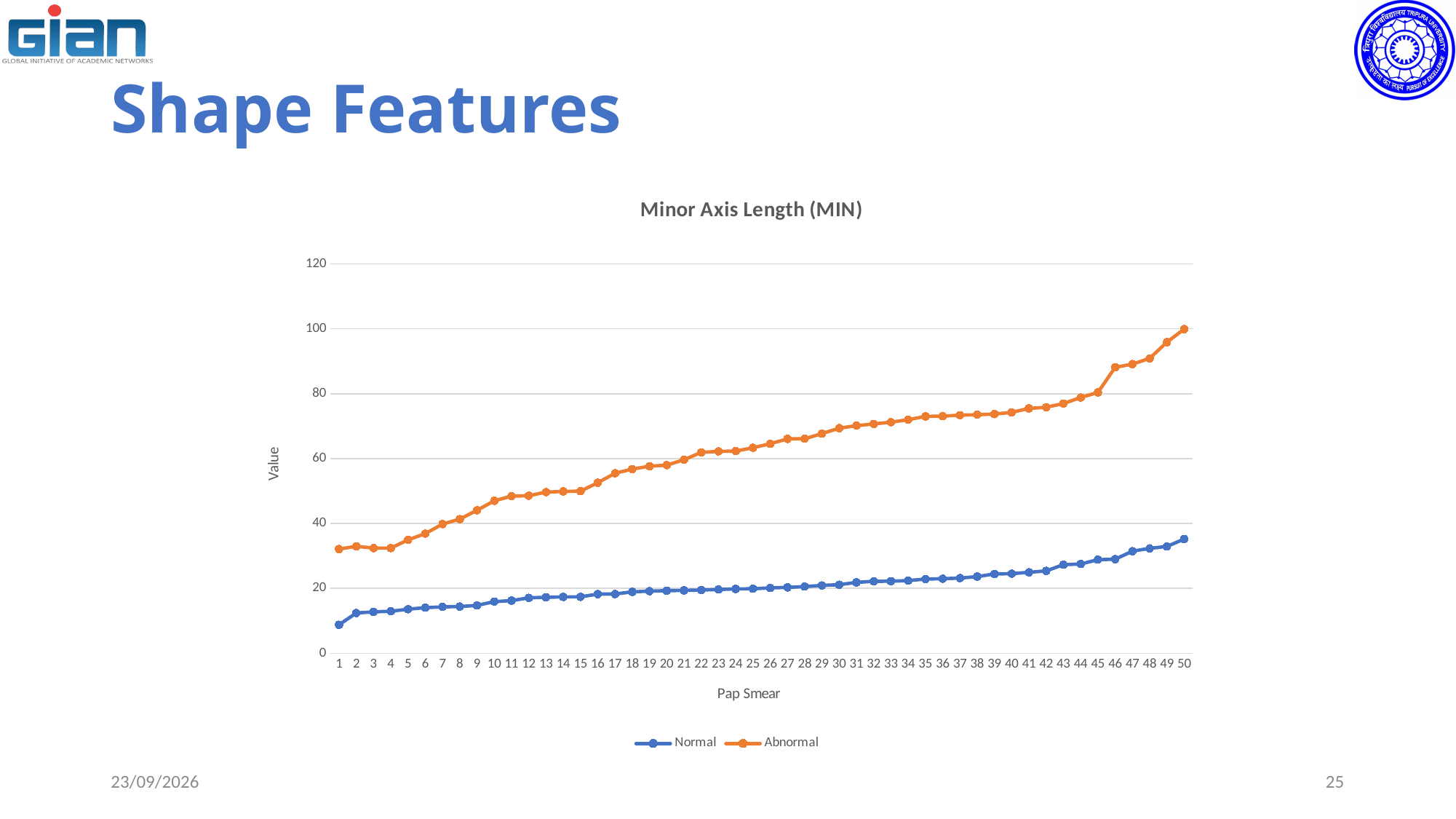
Is the Abnormal value at Pap Smear 50 greater or less than 80? greater Do the Normal values rise or fall along the x axis? rise At Pap Smear 50, which series has the larger value, Normal or Abnormal? Abnormal At which Pap Smear number does the Abnormal series reach its highest value? 50 How many series does the legend list? 2 What kind of chart is shown on the slide? line chart Do the Abnormal values rise or fall as the Pap Smear number increases from 1 to 50? rise How many Pap Smear points are plotted along the x axis for each series? 50 What is the title of the chart? Minor Axis Length (MIN) Is the Normal value at Pap Smear 1 greater or less than 20? less Which series is drawn in orange? Abnormal Is the Abnormal value at Pap Smear 1 greater or less than 40? less